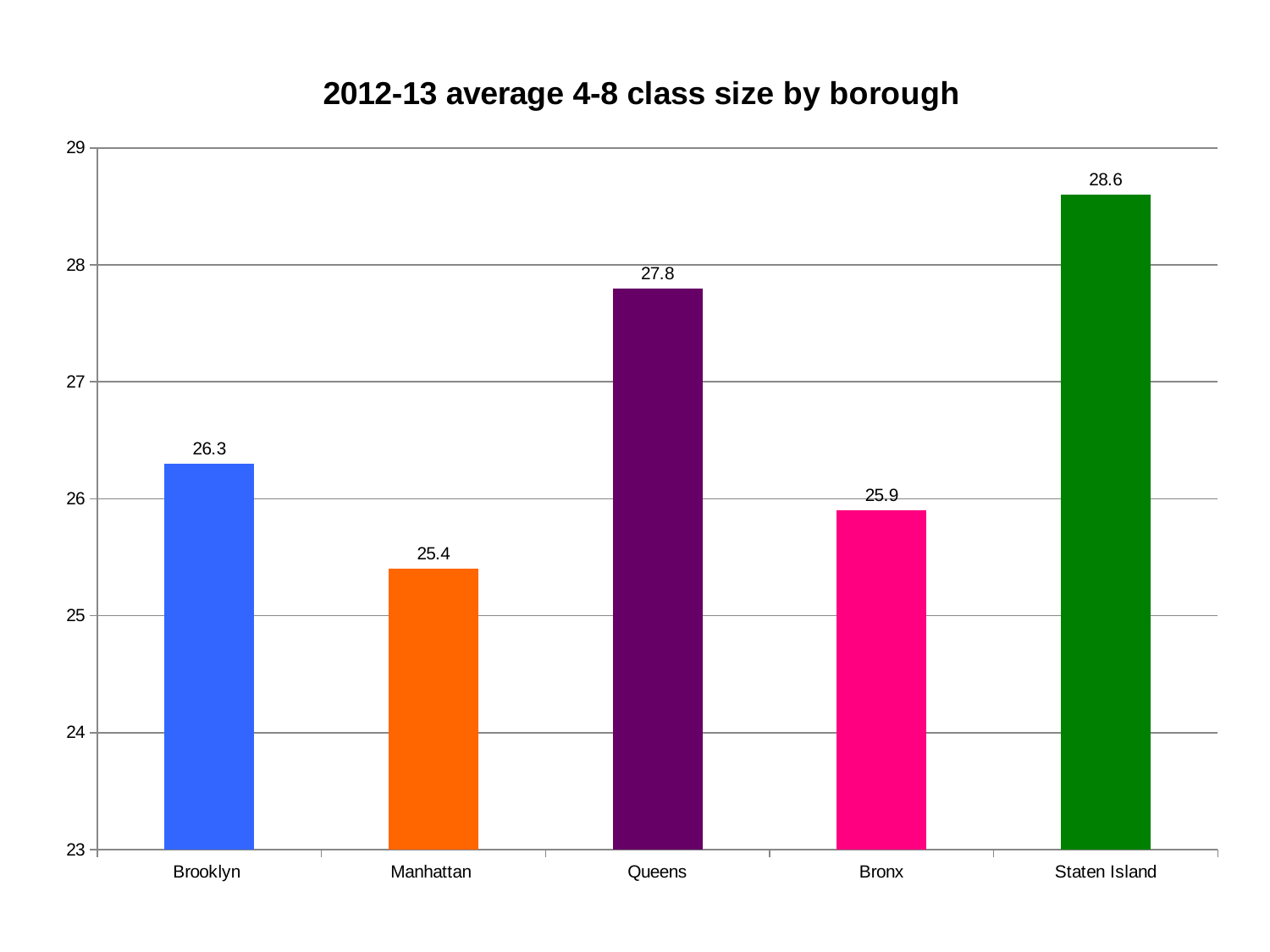
What is the title of the chart? 2012-13 average 4-8 class size by borough What kind of chart is shown on the slide? Bar chart What is the difference between the average class size in Queens and the Bronx? 1.9 Which has a larger average class size, Brooklyn or the Bronx? Brooklyn Which borough has the highest average 4-8 class size? Staten Island What is the average 4-8 class size for Manhattan? 25.4 Is the value for Queens greater or less than 27? greater What is the difference between the average class size in Staten Island and Manhattan? 3.2 What is the average 4-8 class size for Brooklyn? 26.3 What is the average 4-8 class size for Staten Island? 28.6 How many boroughs are shown in the chart? 5 Which borough has the lowest average 4-8 class size? Manhattan